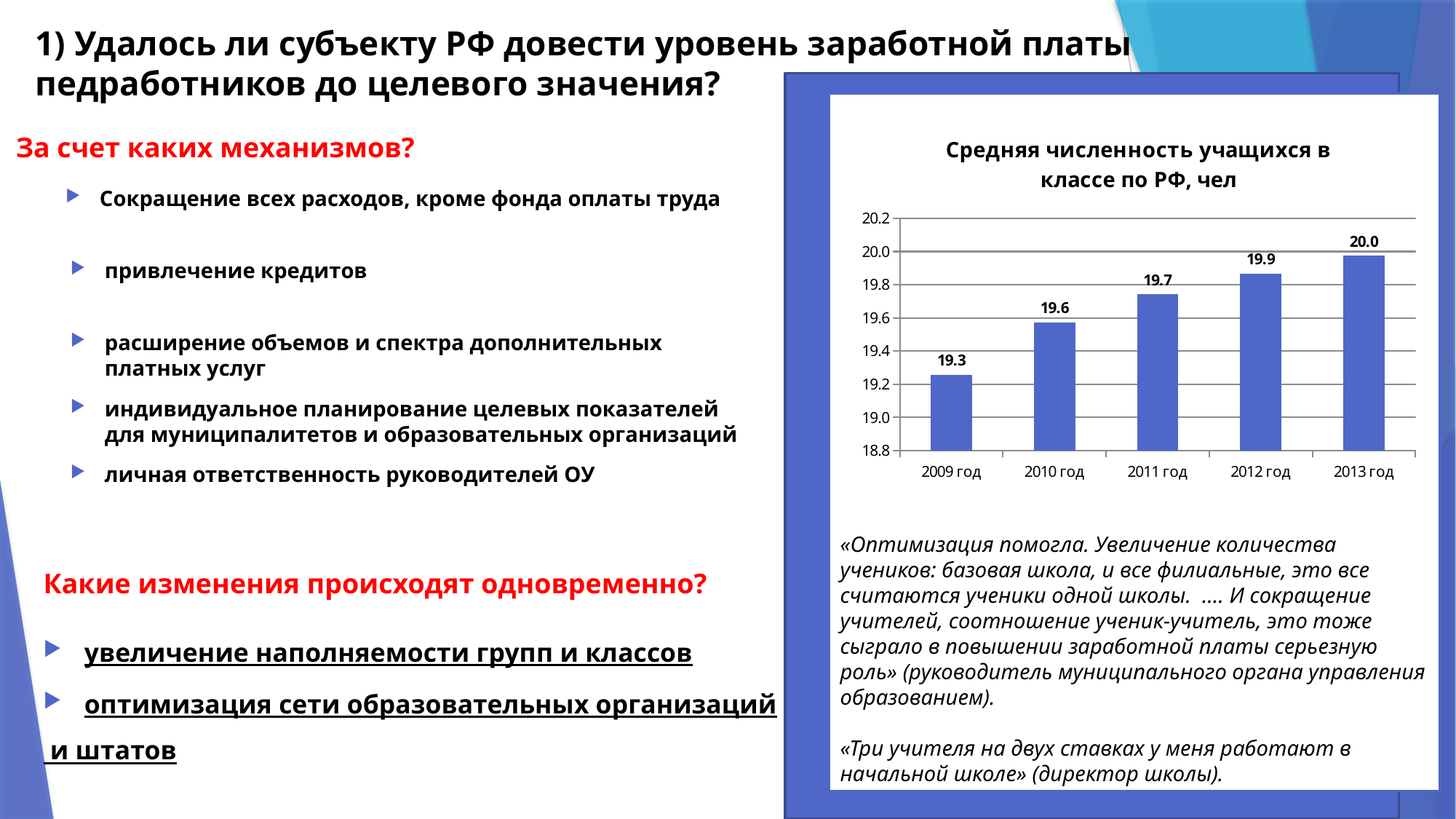
What value is shown for 2013 год? 20.0 Which year has the lowest average class size? 2009 год What is the average class size shown for 2009 год? 19.3 What is the title of the chart? Средняя численность учащихся в классе по РФ, чел Which year has the highest average class size? 2013 год Is the value for 2012 год greater or less than 19.8? greater Do the values rise or fall from 2009 год to 2013 год? rise What kind of chart is shown on the slide? bar chart Which is larger, the value for 2010 год or the value for 2012 год? 2012 год What is the difference between the values for 2013 год and 2009 год? 0.7 How many years are shown on the x axis of the chart? 5 What value is shown for 2011 год? 19.7